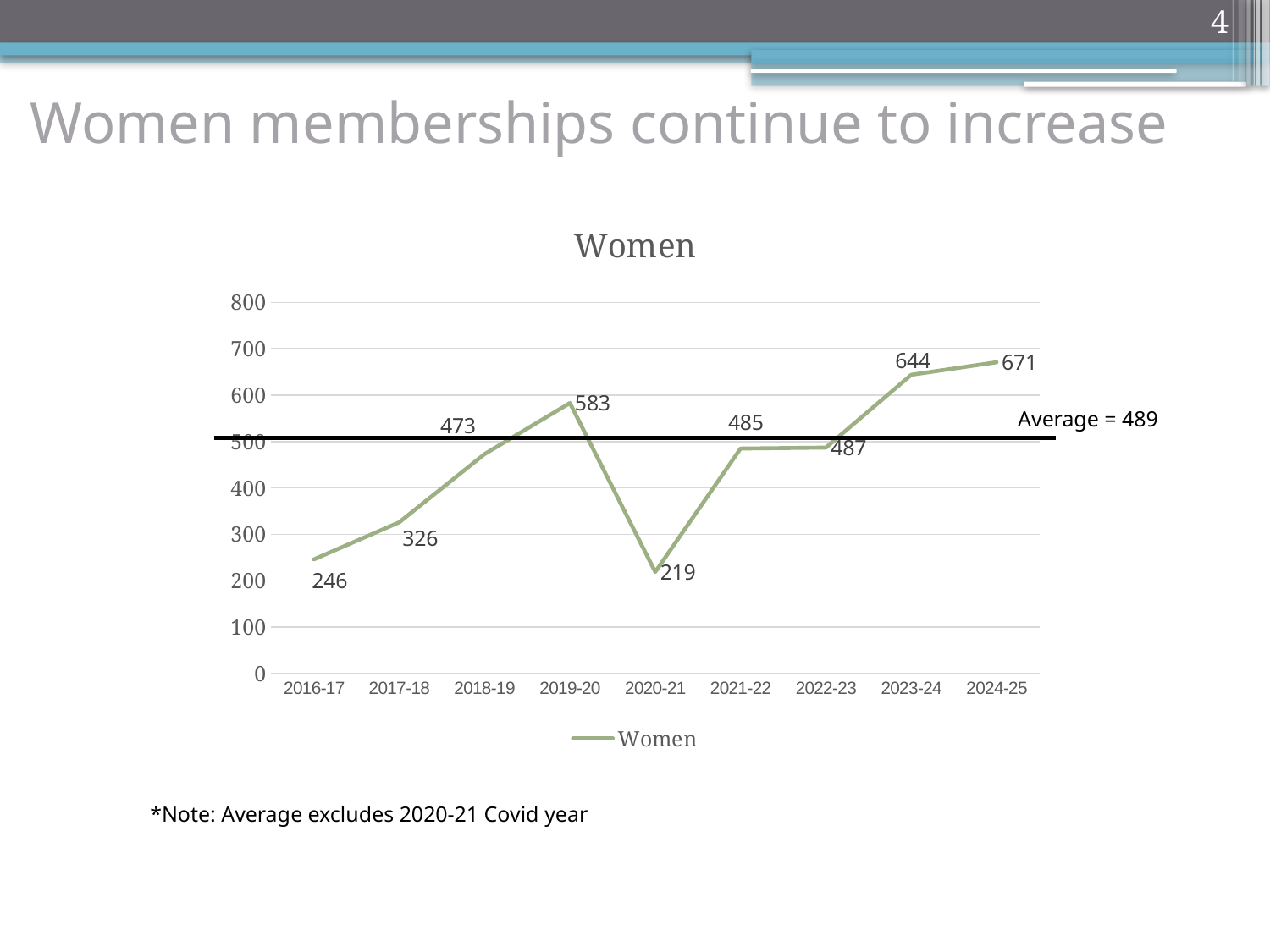
What average value is marked by the horizontal line on the chart? 489 What is the value for 2016-17? 246 What is the value for 2020-21? 219 What is the difference between the values for 2024-25 and 2023-24? 27 Which year has the highest value? 2024-25 What kind of chart is this? line chart What is the difference between the values for 2019-20 and 2020-21? 364 What is the value for 2024-25? 671 Do the values rise or fall from 2020-21 to 2024-25? rise Which is larger, the value for 2018-19 or the value for 2019-20? 2019-20 How many years are plotted on the x axis? 9 Which year has the lowest value? 2020-21